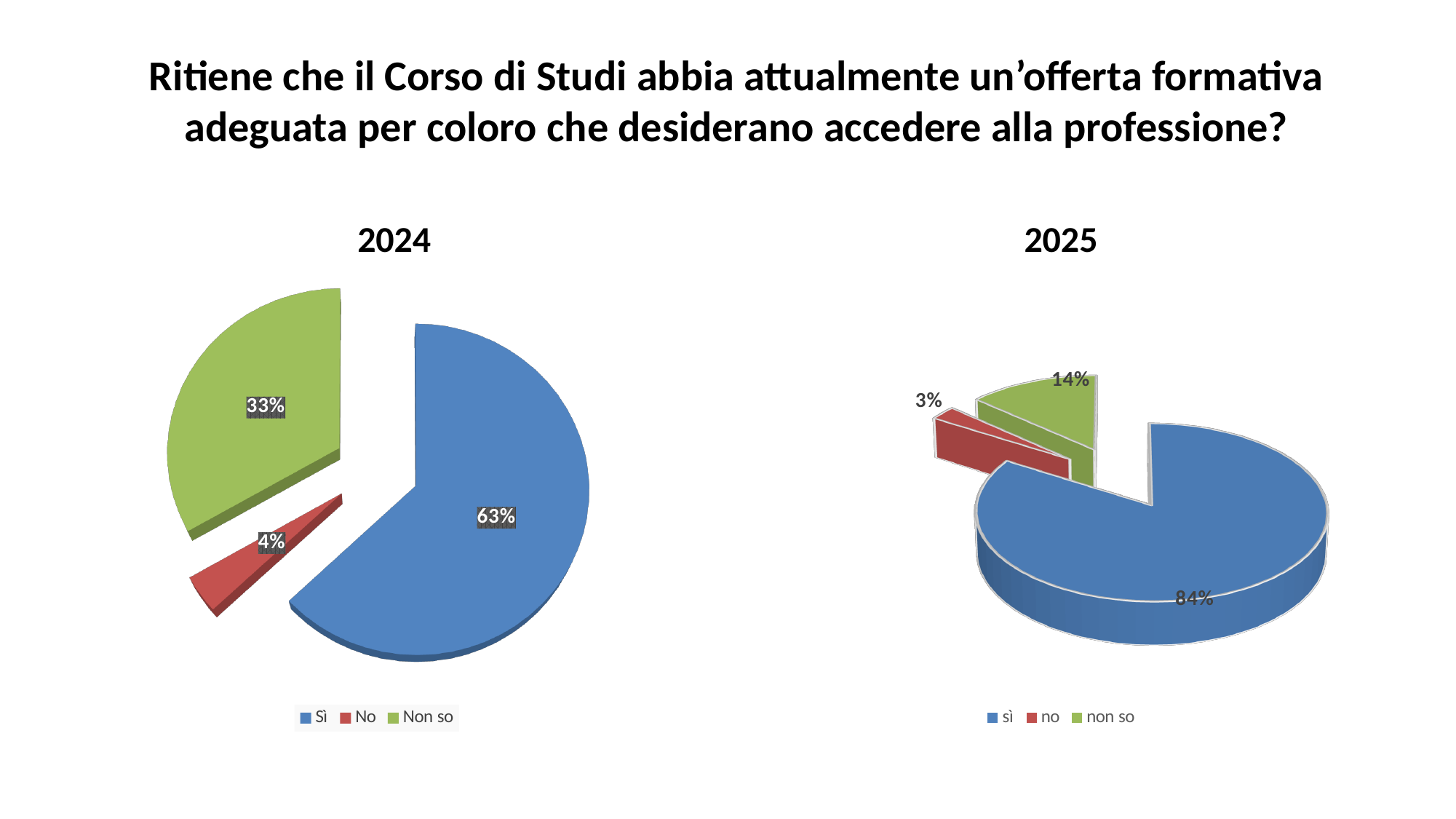
In the 2025 chart, what share of respondents answered "sì"? 84% Is the "Non so" share larger in the 2024 chart or in the 2025 chart? 2024 In the 2025 chart, what share of respondents answered "no"? 3% What kind of chart is the 2025 chart? Pie chart In the 2024 chart, what share of respondents answered "Non so"? 33% In the 2024 chart, what share of respondents answered "Sì"? 63% In the 2024 chart, which answer has the largest slice? Sì How many categories does the legend of the 2024 chart list? 3 In the 2024 chart, what share of respondents answered "No"? 4% In the 2025 chart, which answer has the smallest slice? no What is the difference between the "sì" share in the 2025 chart and the "Sì" share in the 2024 chart? 21 percentage points In the 2025 chart, what share of respondents answered "non so"? 14%